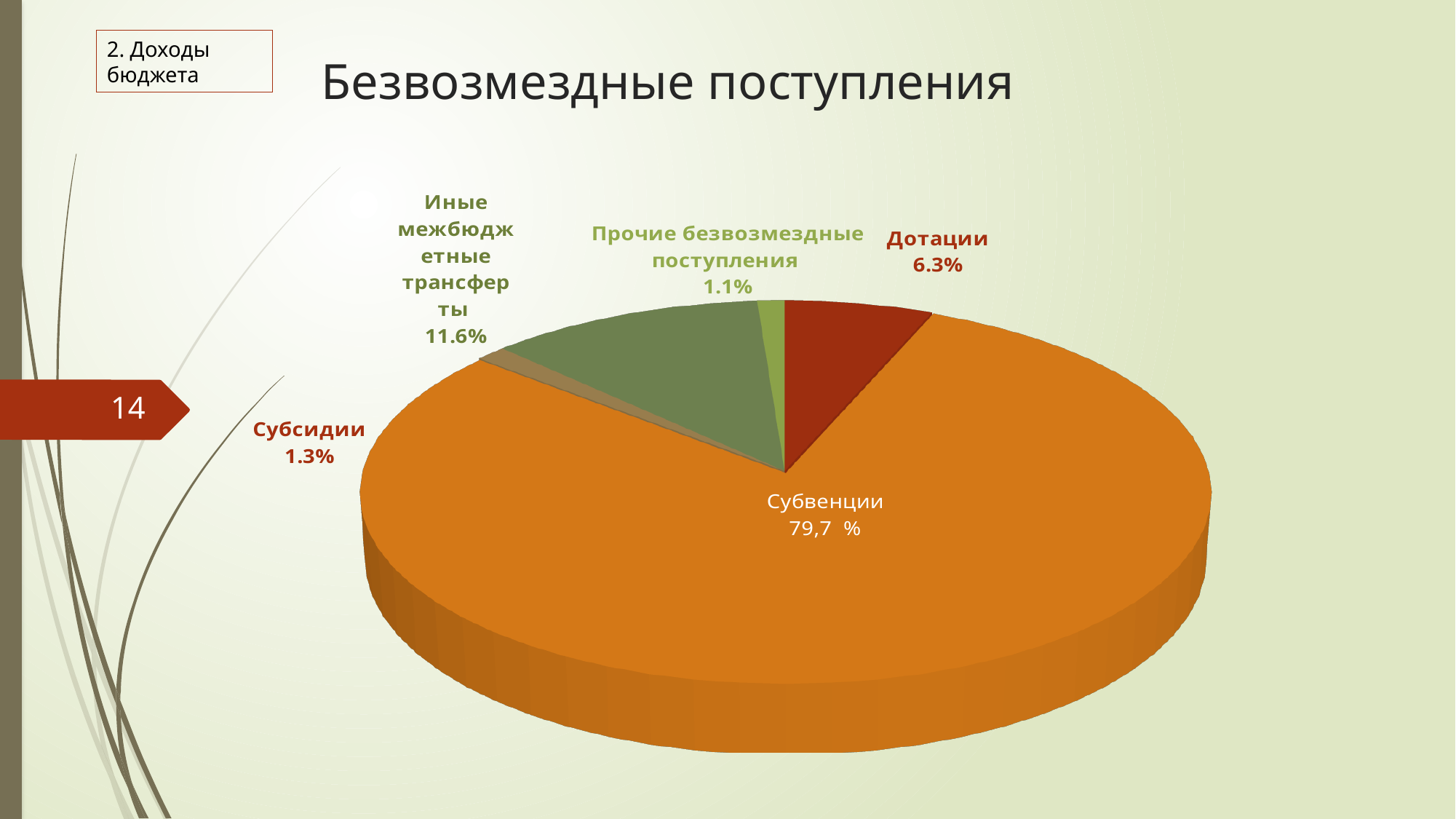
Which category has the smallest slice of the pie? Прочие безвозмездные поступления What is the title of the chart on the slide? Безвозмездные поступления Which is larger, the share for Дотации or the share for Субсидии? Дотации What kind of chart is shown on the slide? Pie chart What percentage is shown for Иные межбюджетные трансферты? 11.6% How many categories are shown in the pie chart? 5 What percentage is shown for Дотации? 6.3% What percentage is shown for Прочие безвозмездные поступления? 1.1% What is the difference in percentage points between Субвенции and Иные межбюджетные трансферты? 68.1 percentage points What share of the pie does Субвенции have? 79,7 % Which category has the largest slice of the pie? Субвенции What percentage is shown for Субсидии? 1.3%